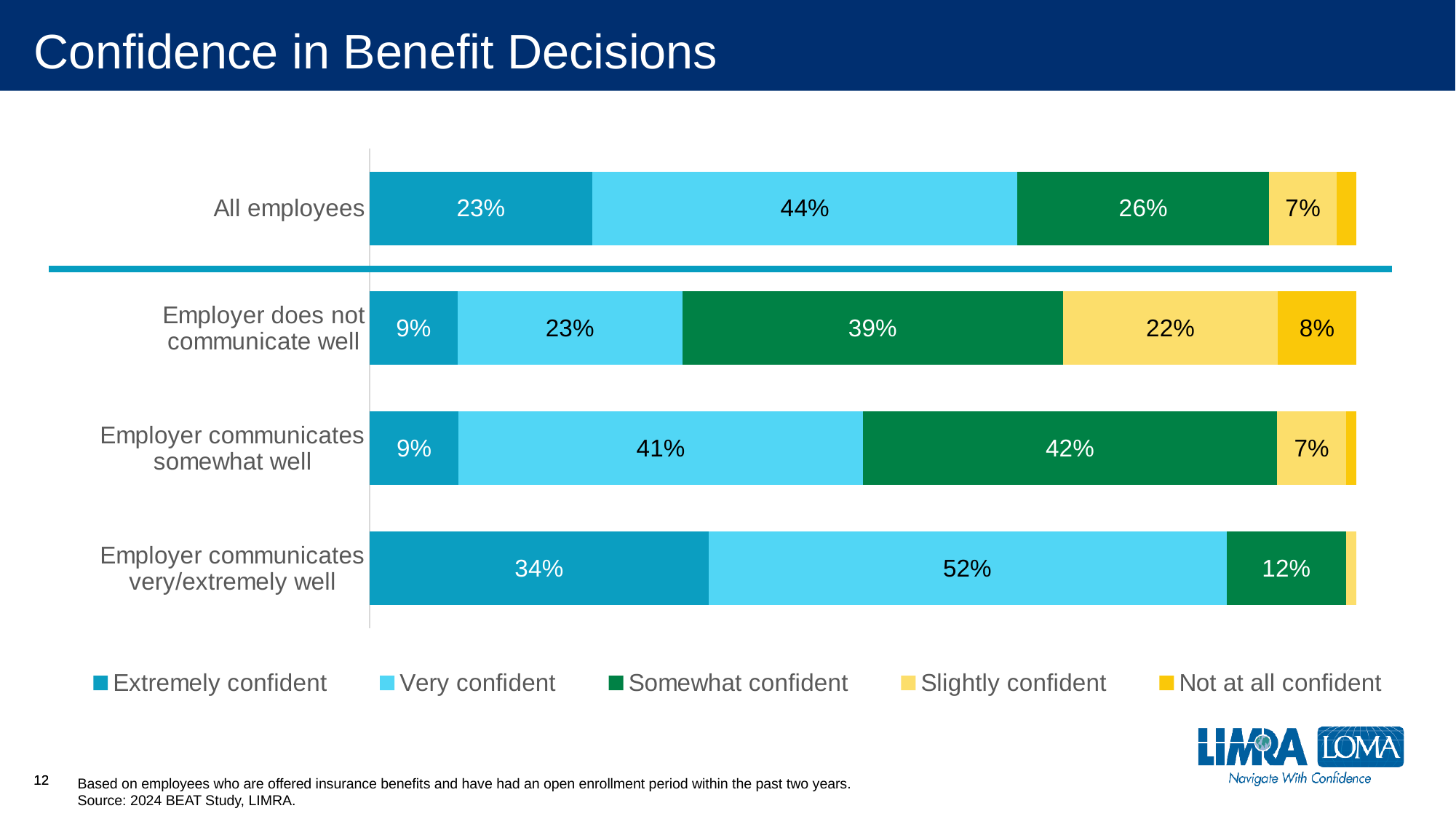
Which employee group has the highest Extremely confident percentage? Employer communicates very/extremely well What percentage of employees whose employer communicates somewhat well are Slightly confident? 7% What is the difference between the Very confident percentage for employees whose employer communicates very/extremely well and for all employees? 8 percentage points What percentage of employees whose employer does not communicate well are Somewhat confident? 39% What type of chart is shown on the slide? Stacked bar chart What percentage of employees whose employer communicates very/extremely well are Extremely confident? 34% What is the title of the chart on the slide? Confidence in Benefit Decisions Which is larger for employees whose employer communicates somewhat well: the Very confident share or the Somewhat confident share? Somewhat confident What percentage of all employees are Very confident? 44% How many series does the legend list? 5 Which employee group has the lowest Very confident percentage? Employer does not communicate well How many employee groups (categories) are shown in the chart? 4